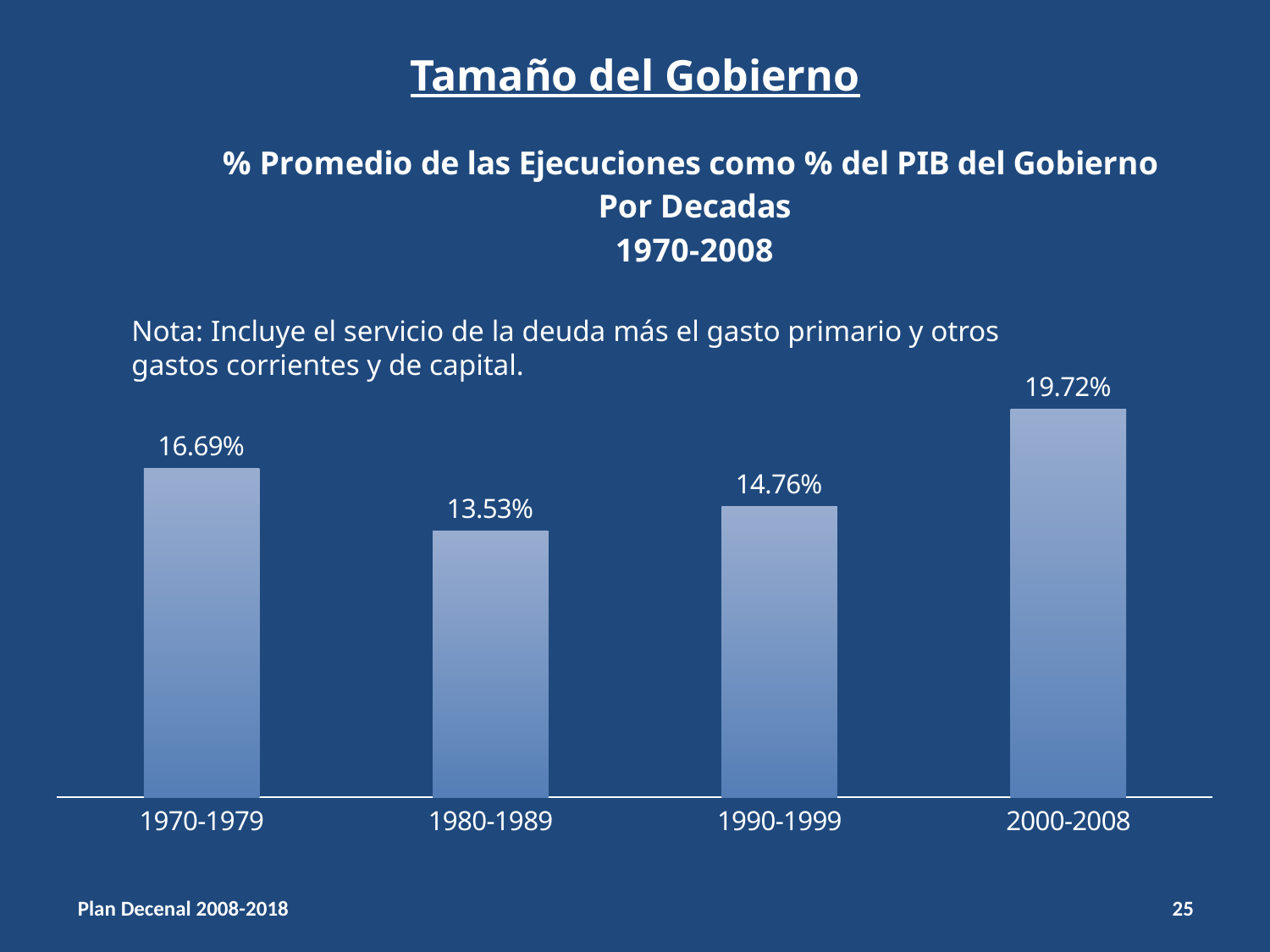
Which is larger, the value for 1970-1979 or the value for 1990-1999? 1970-1979 How many decades are shown on the chart? 4 What kind of chart is shown on the slide? Bar chart Which decade has the lowest value? 1980-1989 What is the value for 1970-1979? 16.69% Which decade has the highest value? 2000-2008 What is the title of the chart? % Promedio de las Ejecuciones como % del PIB del Gobierno Por Decadas 1970-2008 What is the difference between the values for 1970-1979 and 1990-1999? 1.93% What is the value for 1980-1989? 13.53% What is the value for 1990-1999? 14.76% What is the difference between the values for 2000-2008 and 1980-1989? 6.19% What is the value for 2000-2008? 19.72%